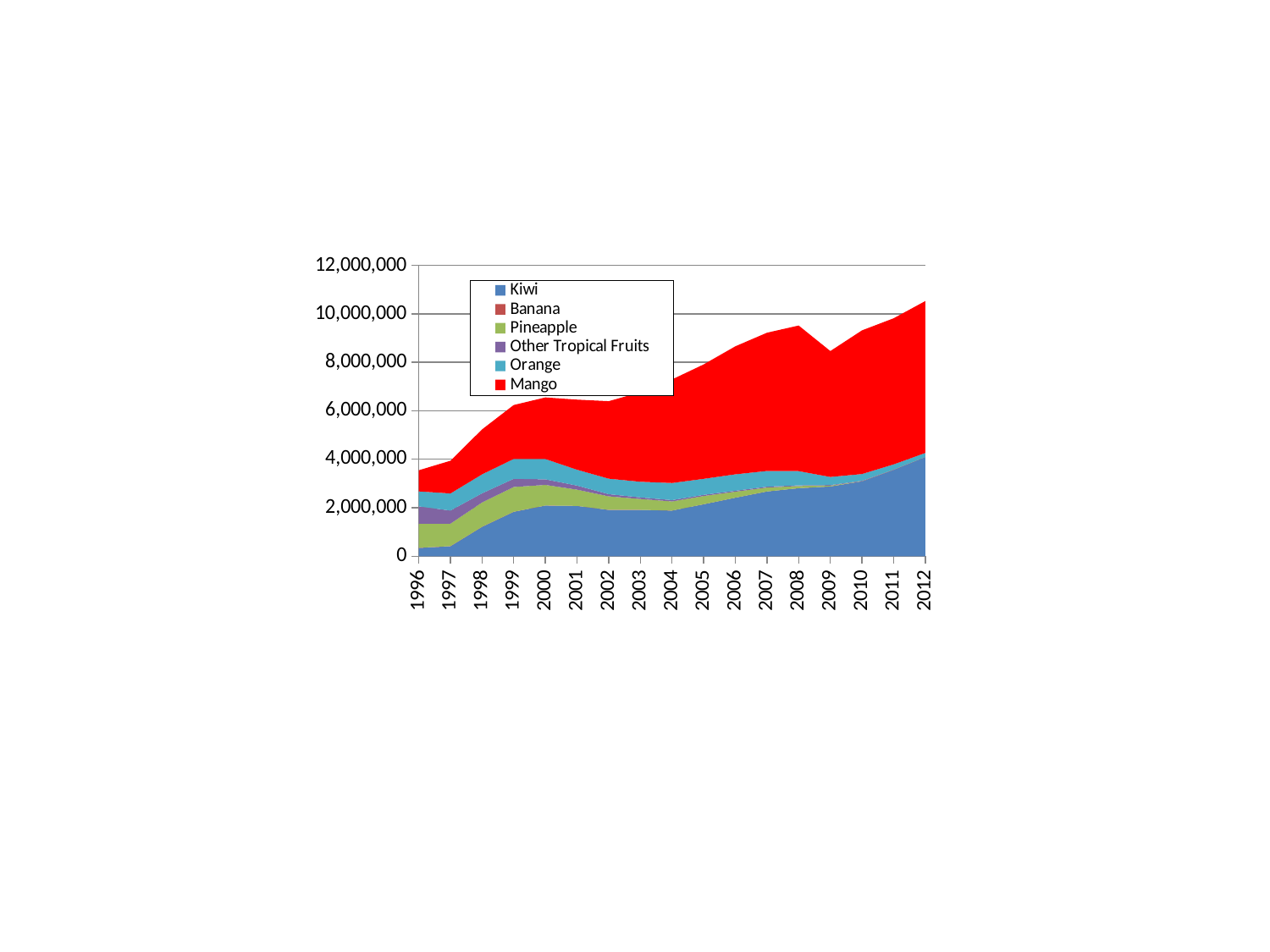
Does the total stacked value generally rise or fall from 1996 to 2012? rise Which series is shown in red? Mango What kind of chart is shown on the slide? Stacked area chart Is the value for Kiwi in 2012 greater or less than 2,000,000? greater How many years are shown along the x axis? 17 Is the total stacked value for 2012 greater or less than 10,000,000? greater Is the total stacked value for 1996 greater or less than 4,000,000? less Does the Kiwi series generally rise or fall from 1996 to 2012? rise Which year is the first on the x axis? 1996 How many series does the legend list? 6